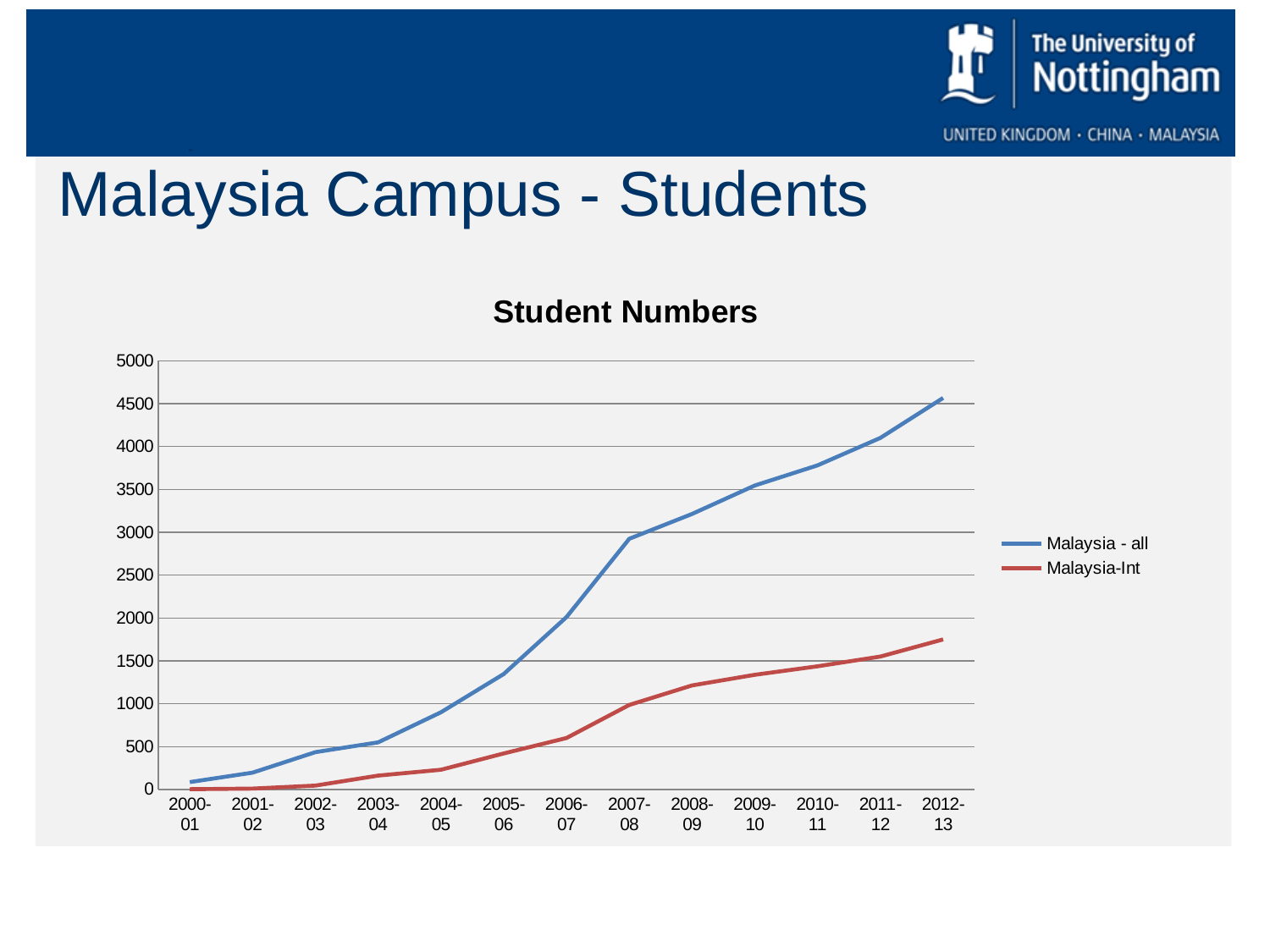
Is the value for Malaysia - all in 2007-08 greater or less than 2500? greater Is the value for Malaysia-Int in 2012-13 greater or less than 1500? greater Is the value for Malaysia-Int in 2004-05 greater or less than 500? less What kind of chart is shown under the title "Student Numbers"? line chart Do the values for the Malaysia - all series rise or fall from 2000-01 to 2012-13? rise In which academic year is the Malaysia-Int series at its lowest? 2000-01 How many series does the legend of the Student Numbers chart list? 2 How many academic years are plotted along the x axis of the Student Numbers chart? 13 In 2012-13, which series has the larger value, Malaysia - all or Malaysia-Int? Malaysia - all What is the title of the chart on the slide? Student Numbers In which academic year is the Malaysia - all series at its highest? 2012-13